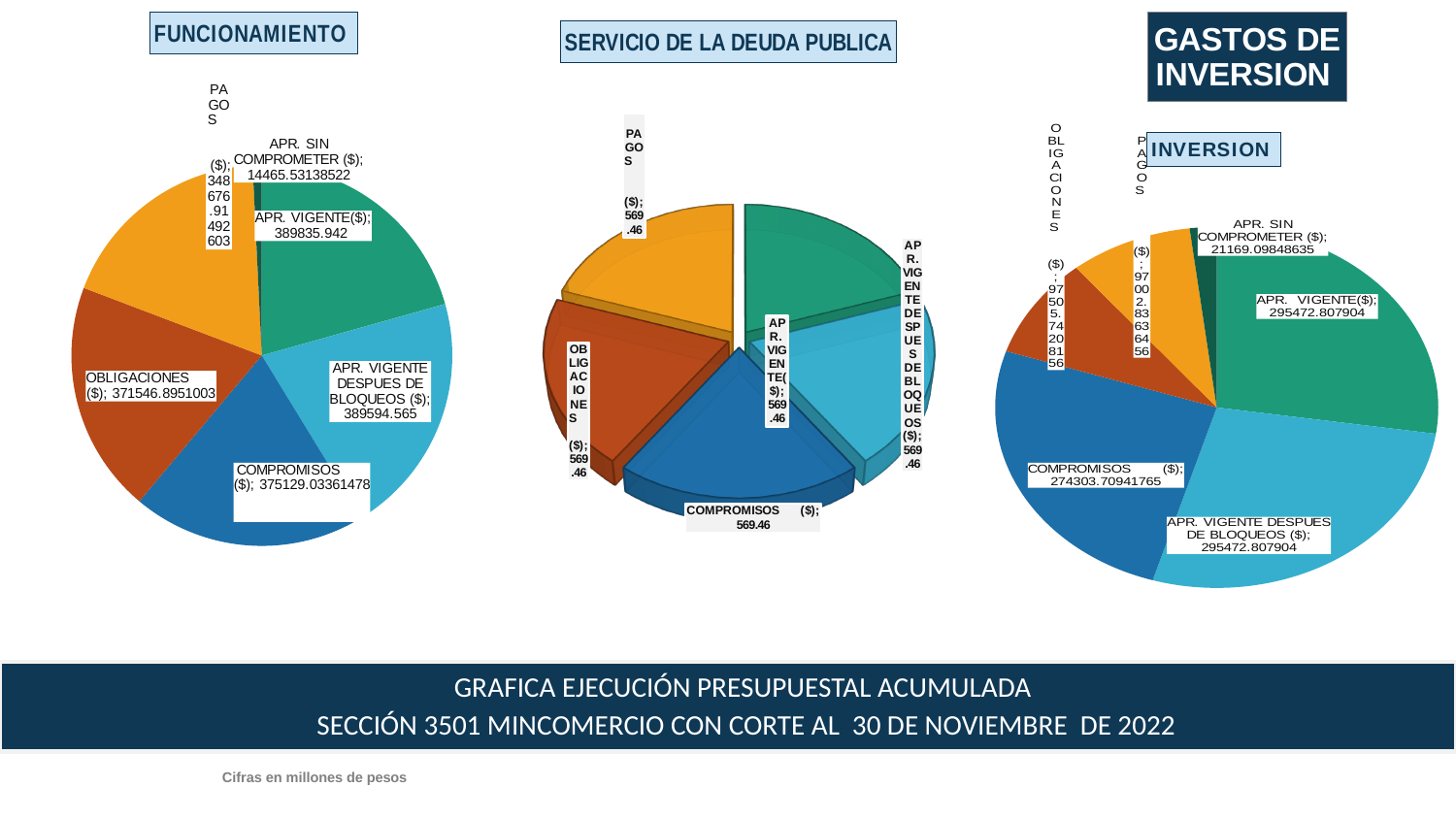
In the INVERSION chart, what is the difference between APR. VIGENTE ($) and COMPROMISOS ($)? 21169.09848635 In the SERVICIO DE LA DEUDA PUBLICA chart, what is the value for COMPROMISOS ($)? 569.46 In the FUNCIONAMIENTO chart, what is the value for OBLIGACIONES ($)? 371546.8951003 In the FUNCIONAMIENTO chart, what is the value for APR. VIGENTE ($)? 389835.942 In the INVERSION chart, what is the value for COMPROMISOS ($)? 274303.70941765 In the FUNCIONAMIENTO chart, what is the difference between APR. VIGENTE ($) and APR. VIGENTE DESPUES DE BLOQUEOS ($)? 241.377 In the INVERSION chart, what is the value for APR. SIN COMPROMETER ($)? 21169.09848635 What kind of chart is the FUNCIONAMIENTO chart? pie chart In the FUNCIONAMIENTO chart, which is larger, COMPROMISOS ($) or OBLIGACIONES ($)? COMPROMISOS ($) In the FUNCIONAMIENTO chart, which category has the smallest value? APR. SIN COMPROMETER ($) How many slices does the FUNCIONAMIENTO pie chart have? 6 In the FUNCIONAMIENTO chart, what is the value for COMPROMISOS ($)? 375129.03361478